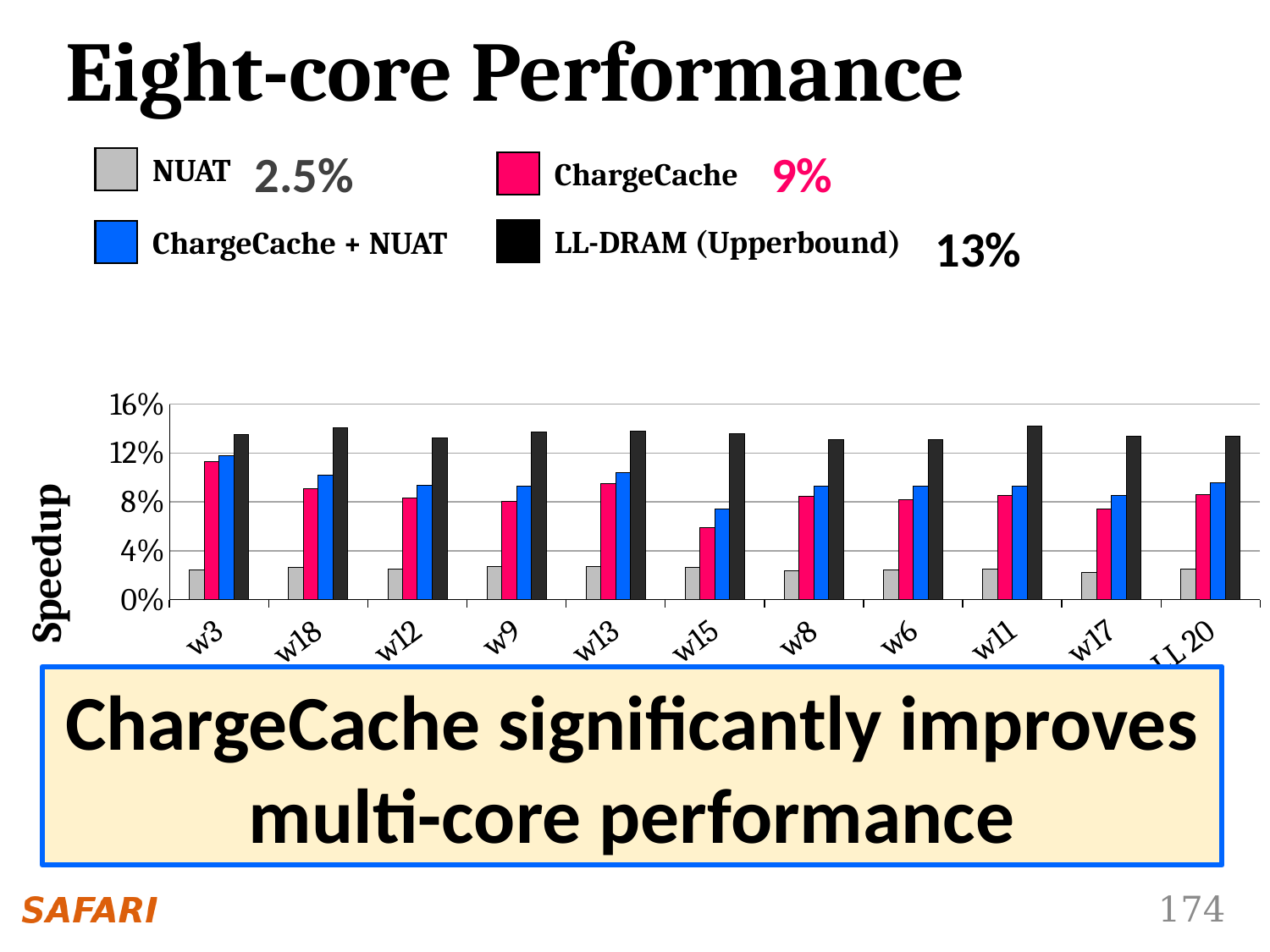
What is the label on the chart's y axis? Speedup What kind of chart is shown on the slide? bar chart For workload w18, which is larger: the ChargeCache speedup or the ChargeCache + NUAT speedup? ChargeCache + NUAT Among the workloads with readable labels, which has the highest ChargeCache speedup? w3 Which series has the tallest bar for workload w3? LL-DRAM (Upperbound) Is the ChargeCache speedup for w3 greater or less than 8%? greater Is the ChargeCache speedup for w15 greater or less than 8%? less How many series does the chart's legend list? 4 How many groups of bars (workloads) are plotted along the x axis? 11 Among the workloads with readable labels, which has the lowest ChargeCache speedup? w15 Is the NUAT speedup for w18 greater or less than 4%? less